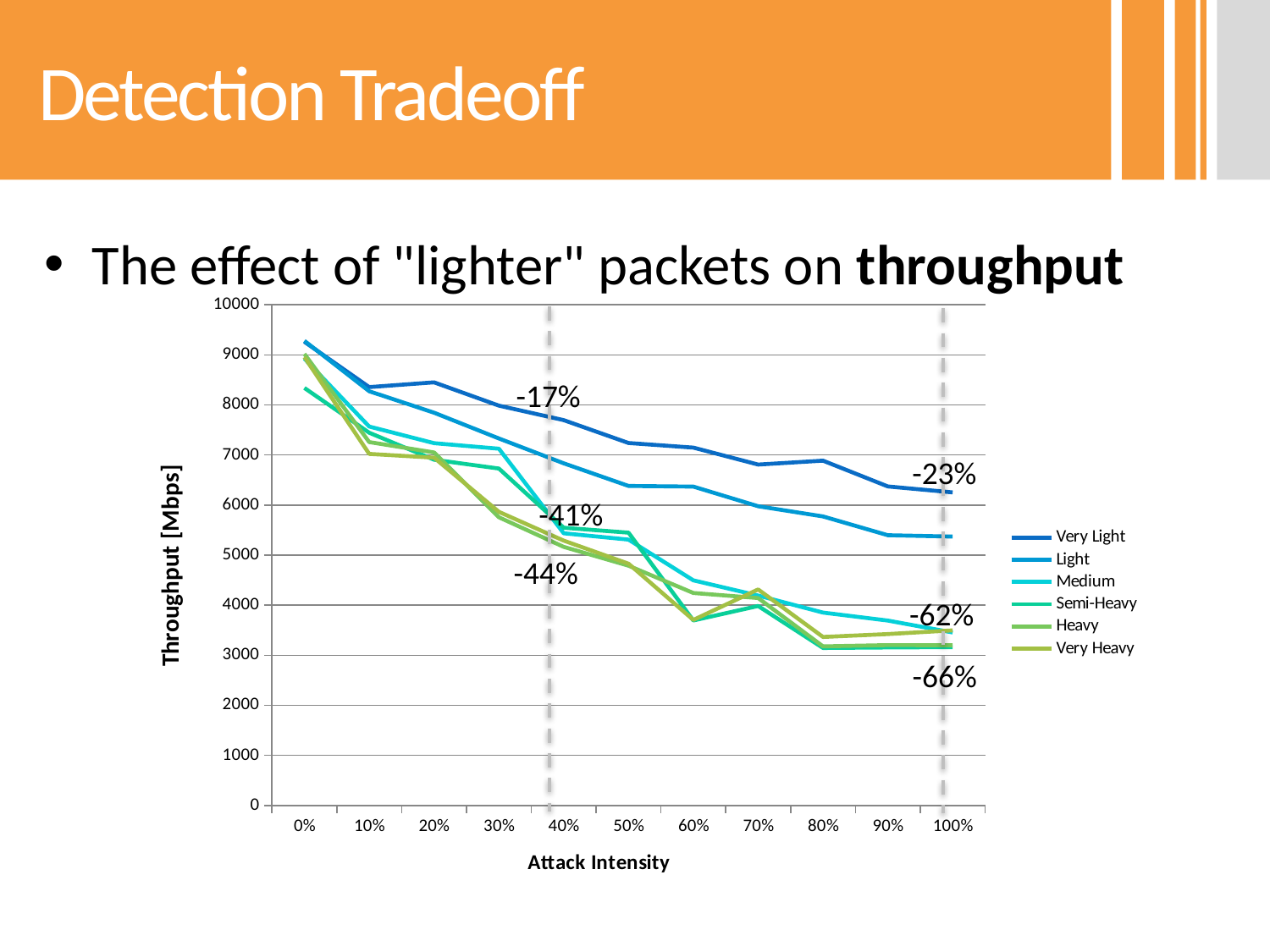
What kind of chart is shown on the slide? line chart At 50% attack intensity, which has the higher throughput, Very Light or Very Heavy? Very Light Is the throughput for Very Heavy at 100% attack intensity greater or less than 4000? less Do the throughput values rise or fall as attack intensity increases from 0% to 100%? fall How many series does the legend list? 6 What is the title of the y axis? Throughput [Mbps] Is the throughput for Very Light at 0% attack intensity greater or less than 9000? greater How many attack intensity points are plotted along the x axis? 11 Is the throughput for Very Light at 100% attack intensity greater or less than 6000? greater Which series has the highest throughput at 100% attack intensity? Very Light What is the title of the x axis? Attack Intensity